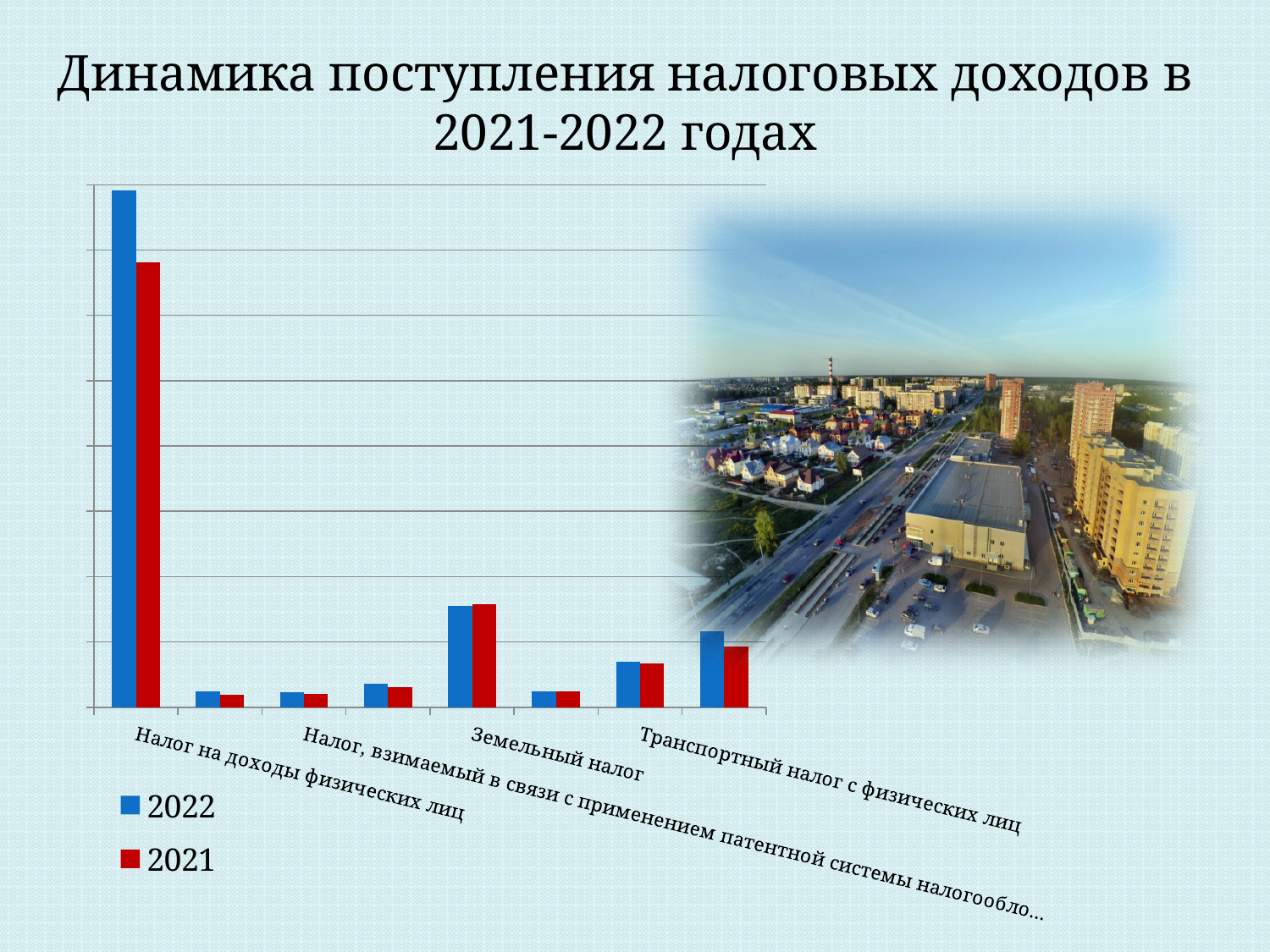
What kind of chart is shown on the slide? Bar chart What is the title of the slide containing the chart? Динамика поступления налоговых доходов в 2021-2022 годах Which category has a higher 2022 bar: Налог на доходы физических лиц or Земельный налог? Налог на доходы физических лиц How many series does the legend list? 2 Which series contains the single tallest bar in the chart? 2022 Which category has the tallest bars in the chart? Налог на доходы физических лиц For Налог на доходы физических лиц, which year has the higher bar, 2022 or 2021? 2022 Is the 2022 bar for Налог на доходы физических лиц taller or shorter than the 2021 bar for the same category? Taller Which years are listed in the chart legend? 2022 and 2021 How many groups of bars (categories) are plotted in the chart? 8